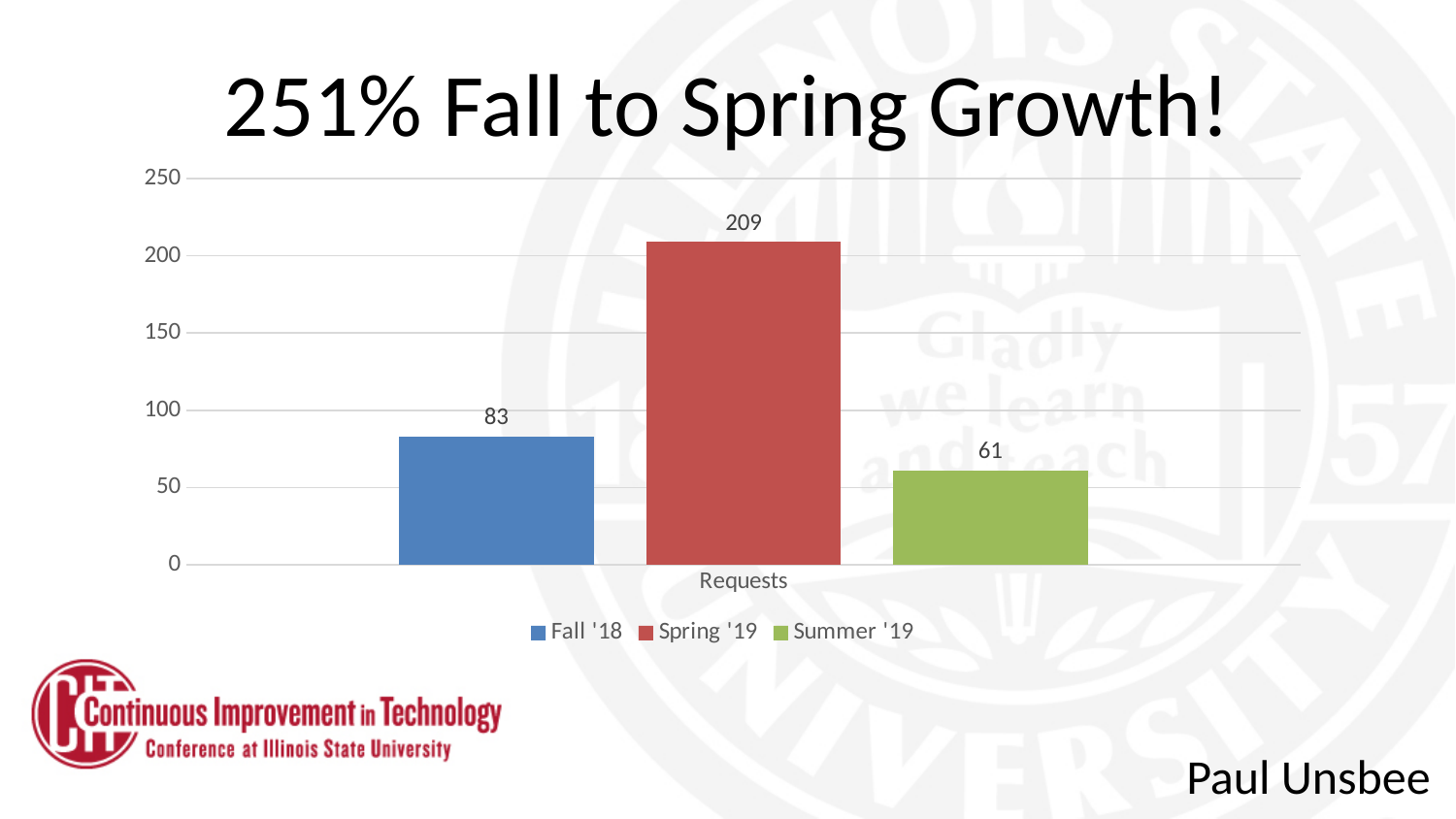
What is the value for Fall '18 in the Requests chart? 83 What is the value for Summer '19 in the Requests chart? 61 Which series has the lowest value in the chart? Summer '19 Is the value for Spring '19 greater or less than 200? greater What kind of chart is shown on the slide? Bar chart Which series has the highest value in the chart? Spring '19 Which is larger, the value for Fall '18 or the value for Summer '19? Fall '18 What is the value for Spring '19 in the Requests chart? 209 What is the difference between the Spring '19 and Fall '18 values? 126 What is the difference between the Fall '18 and Summer '19 values? 22 How many series does the legend list? 3 What is the title of the slide above the chart? 251% Fall to Spring Growth!